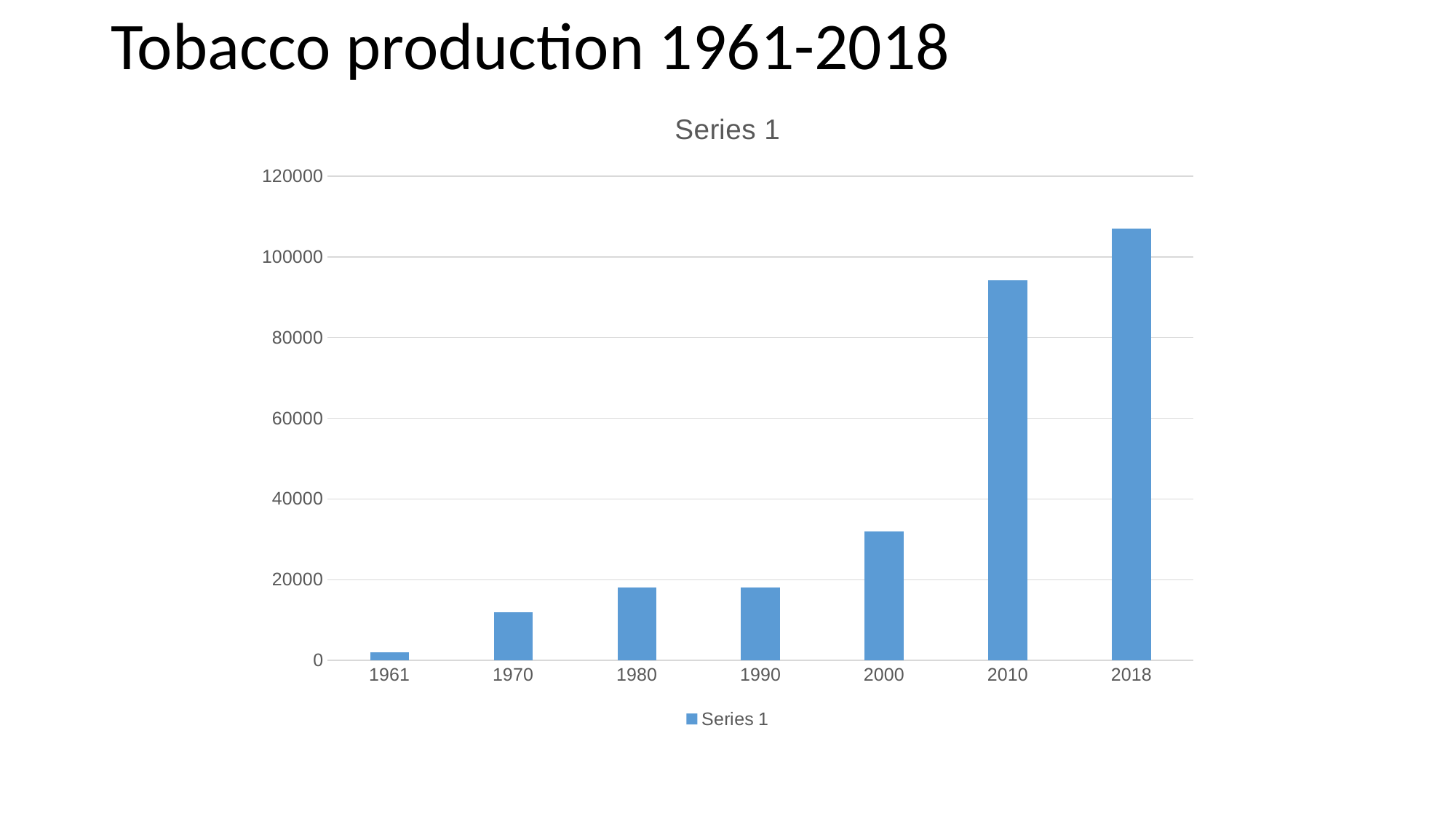
Which year has the highest tobacco production in the chart? 2018 Do the values generally rise or fall from 1961 to 2018? rise Is the value for 1970 greater or less than 20000? less Is the value for 2000 greater or less than 20000? greater Which year has the lowest tobacco production in the chart? 1961 How many years are shown on the x axis of the chart? 7 Is the value for 2010 greater or less than 100000? less How many series does the legend list? 1 What is the title of the slide? Tobacco production 1961-2018 Which is larger, the value for 2000 or the value for 2010? 2010 What kind of chart is shown on the slide? bar chart